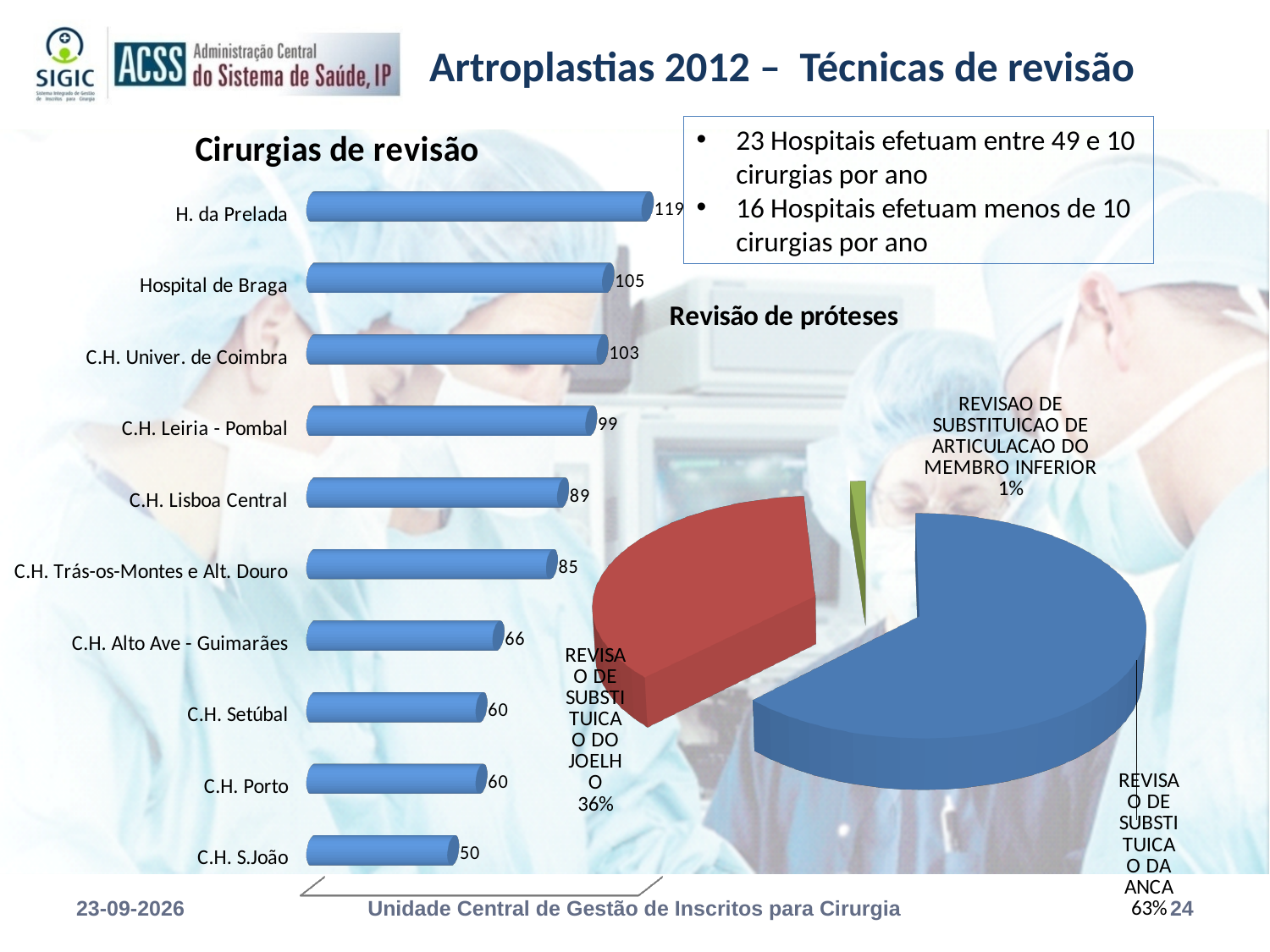
How many slices does the 'Revisão de próteses' pie chart have? 3 In the 'Revisão de próteses' pie chart, what share does 'Revisão de substituição do joelho' have? 36% How many hospitals are shown in the 'Cirurgias de revisão' chart? 10 In the 'Cirurgias de revisão' chart, which hospital has the lowest value? C.H. S.João In the 'Revisão de próteses' pie chart, which slice is the smallest? Revisão de substituição de articulação do membro inferior In the 'Cirurgias de revisão' chart, what is the difference between the values for H. da Prelada and C.H. S.João? 69 In the 'Cirurgias de revisão' chart, which hospital has the highest value? H. da Prelada In the 'Revisão de próteses' pie chart, what share does 'Revisão de substituição da anca' have? 63% What kind of chart is 'Cirurgias de revisão'? Bar chart In the 'Cirurgias de revisão' chart, what is the value for C.H. Lisboa Central? 89 In the 'Cirurgias de revisão' chart, what is the value for Hospital de Braga? 105 In the 'Cirurgias de revisão' chart, which is larger: the value for C.H. Leiria - Pombal or the value for C.H. Alto Ave - Guimarães? C.H. Leiria - Pombal